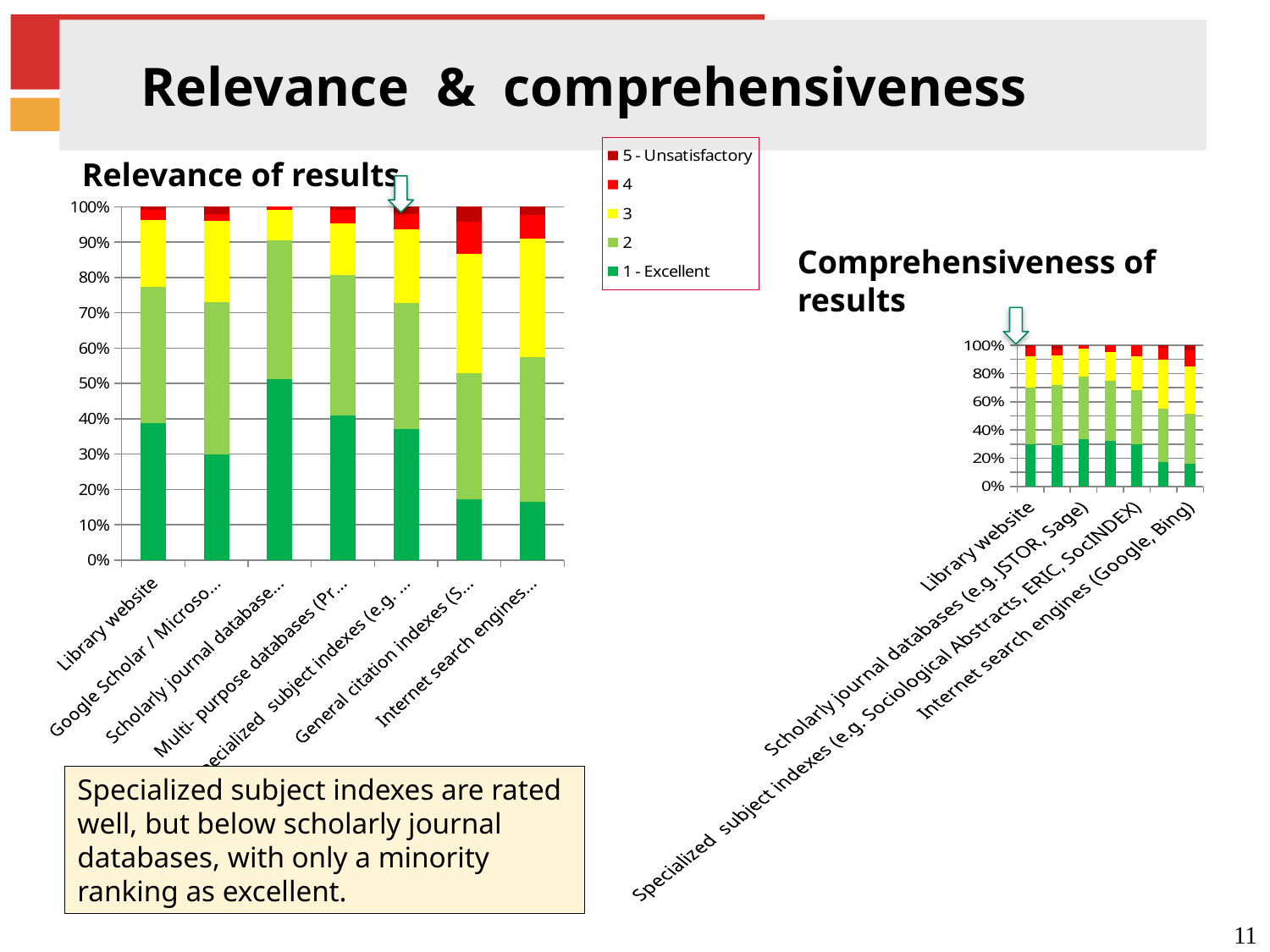
What colour represents the "1 - Excellent" rating in the charts? Dark green In the "Relevance of results" chart, is the "1 - Excellent" share for Internet search engines greater or less than 20%? less What kind of chart is the "Relevance of results" chart? Stacked bar chart In the "Relevance of results" chart, is the "1 - Excellent" share for Scholarly journal databases greater or less than 40%? greater In the "Relevance of results" chart, which has the larger "1 - Excellent" share: Library website or Google Scholar / Microsoft? Library website In the "Relevance of results" chart, which has the larger "1 - Excellent" share: Scholarly journal databases or Specialized subject indexes? Scholarly journal databases In the "Relevance of results" chart, is the "1 - Excellent" share for General citation indexes greater or less than 20%? less How many categories (bars) does the "Relevance of results" chart show? 7 Which legend entry is listed first (at the top) in the legend? 5 - Unsatisfactory In the "Relevance of results" chart, which category has the largest "1 - Excellent" share? Scholarly journal database... How many series does the legend list for the charts on this slide? 5 How many bars does the "Comprehensiveness of results" chart show? 7